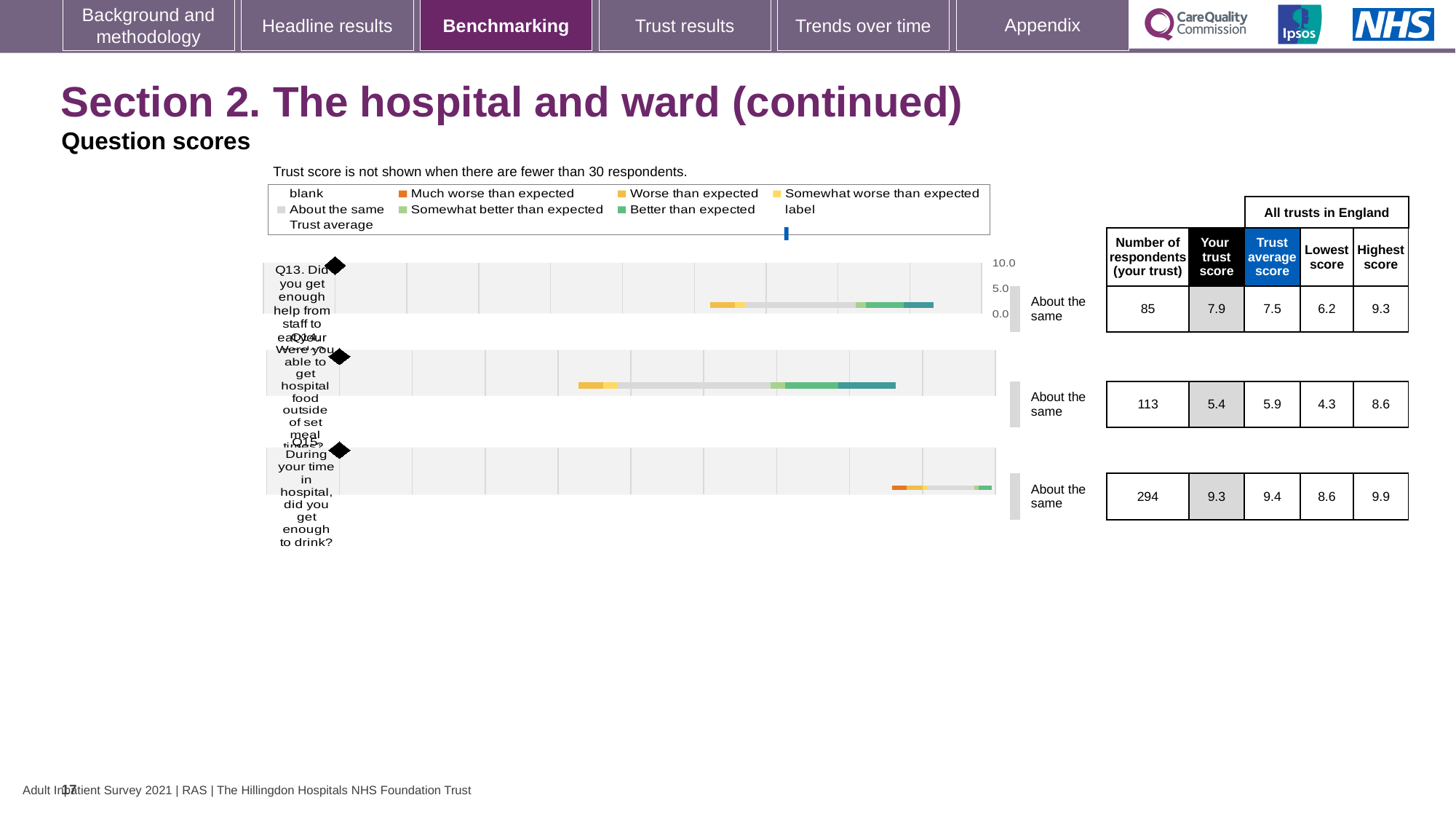
What is the trust score for Q14 (Were you able to get hospital food outside of set meal times?)? 5.4 Which question has the highest trust score? Q15 What is the difference between the highest score and the lowest score across all trusts in England for Q13? 3.1 What is the benchmark category shown for Q13? About the same Is the trust score for Q14 higher or lower than the trust average score for Q14? lower What is the trust average score for Q14? 5.9 What is the trust score for Q13 (Did you get enough help from staff to eat your meals?)? 7.9 Which question has the lowest trust score? Q14 How many questions (categories) are plotted in the chart? 3 How many respondents answered Q15 for this trust? 294 What is the trust score for Q15 (During your time in hospital, did you get enough to drink?)? 9.3 What kind of chart is used to show the question scores on this slide? bar chart